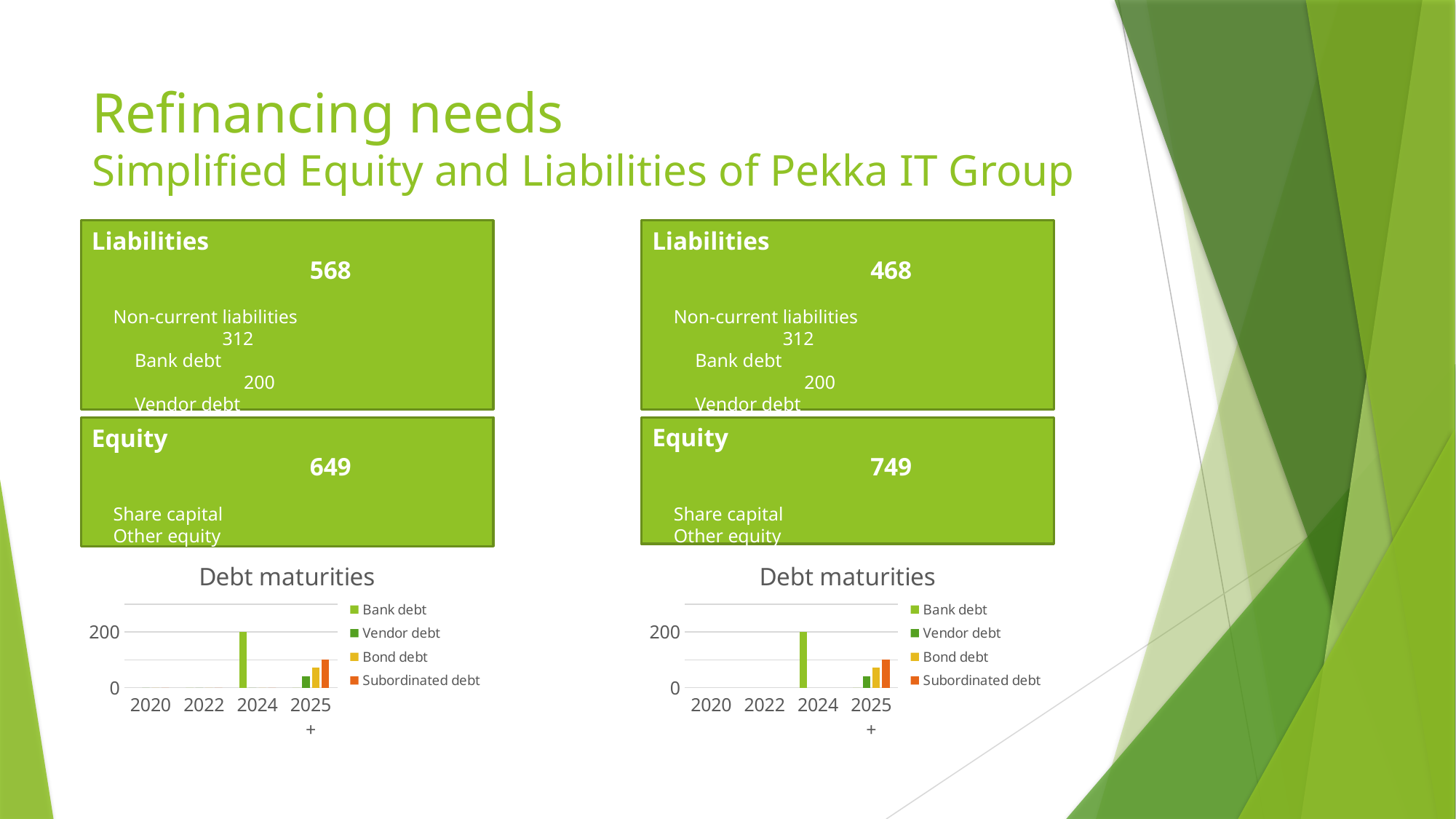
In the right Debt maturities chart, which series has the shortest bar in 2025+? Vendor debt In the left Debt maturities chart, is the value for Subordinated debt in 2025+ greater or less than 200? less In the right Debt maturities chart, which series is shown in orange in the legend? Subordinated debt In the left Debt maturities chart, what kind of chart is shown? bar chart In the right Debt maturities chart, which year has the tallest bar? 2024 In the right Debt maturities chart, how many series does the legend list? 4 In the left Debt maturities chart, in which year does the Bank debt bar appear? 2024 What is the title of the chart on the right side of the slide? Debt maturities In the left Debt maturities chart, which is larger: Bank debt in 2024 or Vendor debt in 2025+? Bank debt in 2024 In the left Debt maturities chart, what is the value of Bank debt in 2024? 200 In the left Debt maturities chart, how many categories are shown on the x axis? 4 In the right Debt maturities chart, is the value for Bond debt in 2025+ greater or less than 200? less